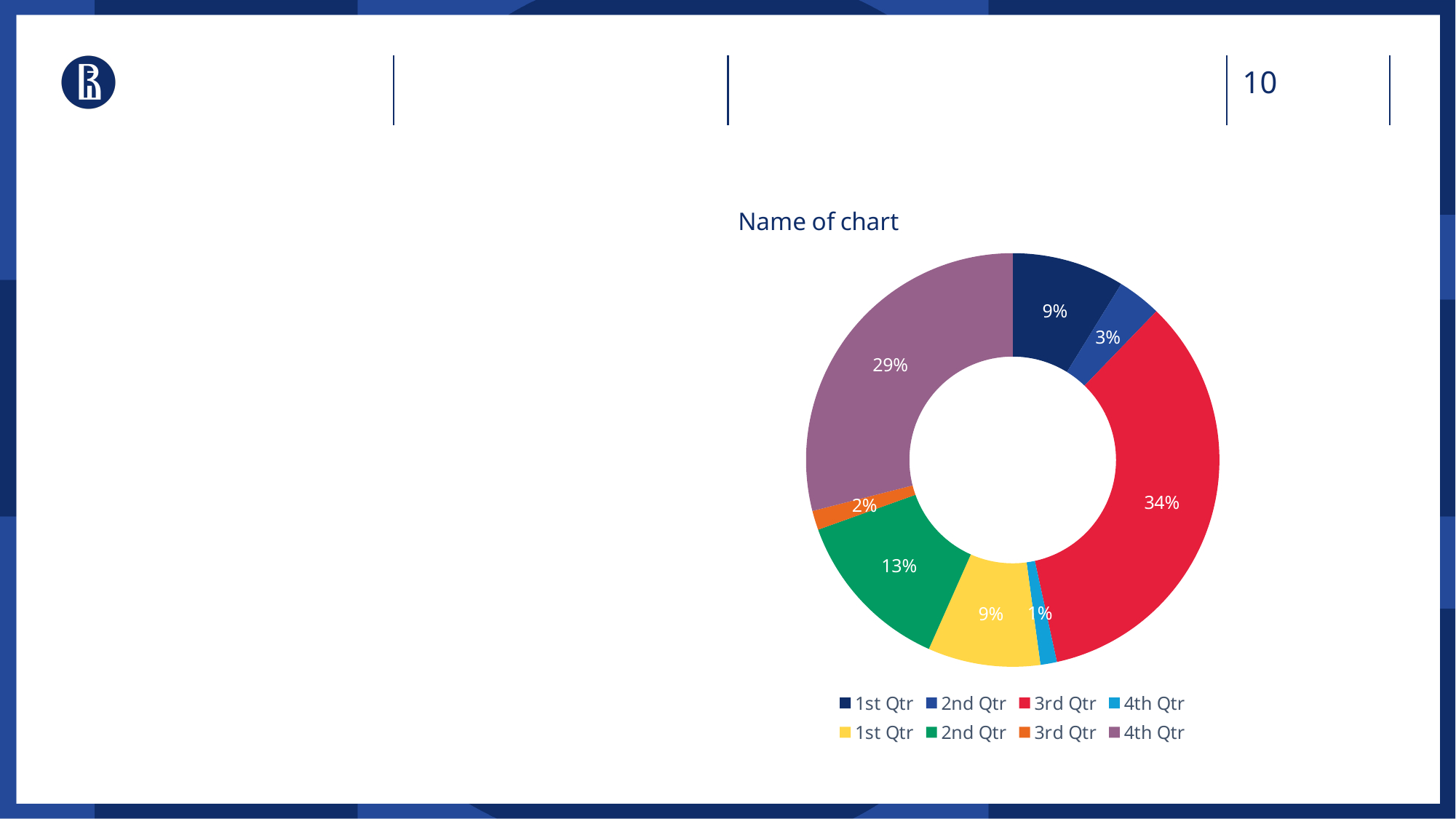
What percentage is shown on the orange slice (3rd Qtr)? 2% What is the largest percentage shown on the chart? 34% What is the difference between the red slice (34%) and the purple slice (29%)? 5% What percentage is shown on the red slice (3rd Qtr)? 34% What type of chart is shown on the slide? doughnut chart How many entries does the chart legend list? 8 What percentage is shown on the purple slice (4th Qtr)? 29% How many slices does the doughnut chart have? 8 Which slice is larger, the green slice or the yellow slice? the green slice What is the title of the chart? Name of chart What is the smallest percentage shown on the chart? 1% What percentage is shown on the green slice (2nd Qtr)? 13%